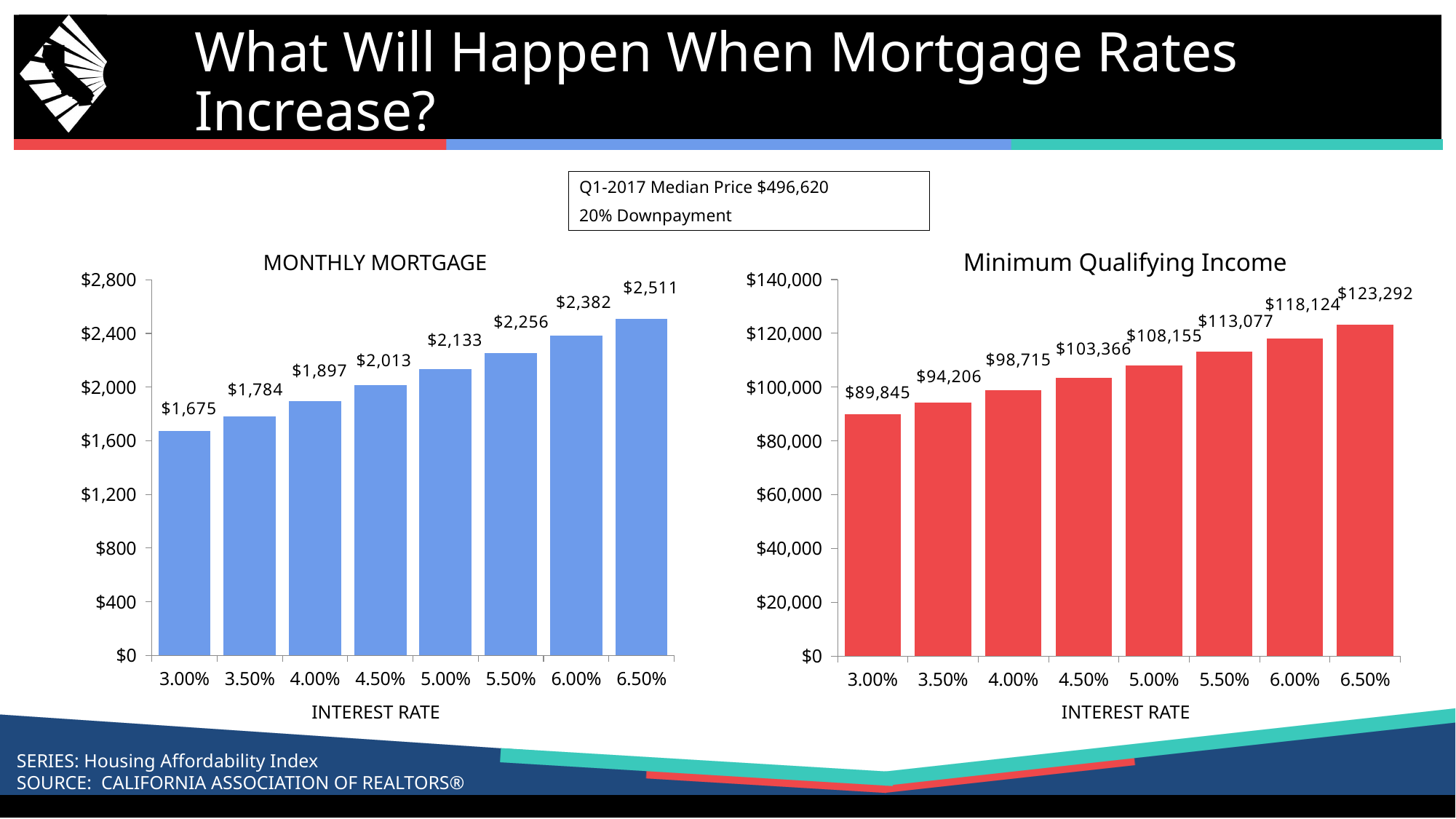
What type of chart is the Minimum Qualifying Income chart? bar chart In the MONTHLY MORTGAGE chart, which is larger: the monthly mortgage at 5.00% or at 5.50%? 5.50% In the MONTHLY MORTGAGE chart, which interest rate has the highest monthly mortgage? 6.50% In the MONTHLY MORTGAGE chart, what is the difference between the monthly mortgage at 6.50% and at 3.00%? $836 In the Minimum Qualifying Income chart, which interest rate has the lowest minimum qualifying income? 3.00% How many interest rate categories are shown in the MONTHLY MORTGAGE chart? 8 What is the x-axis title of the Minimum Qualifying Income chart? INTEREST RATE In the MONTHLY MORTGAGE chart, what is the monthly mortgage at a 4.50% interest rate? $2,013 In the Minimum Qualifying Income chart, what is the difference between the income at 4.00% and at 3.50%? $4,509 In the Minimum Qualifying Income chart, is the value for 4.50% greater or less than $100,000? greater In the Minimum Qualifying Income chart, what is the minimum qualifying income at a 5.50% interest rate? $113,077 In the MONTHLY MORTGAGE chart, do the values rise or fall as the interest rate increases? rise